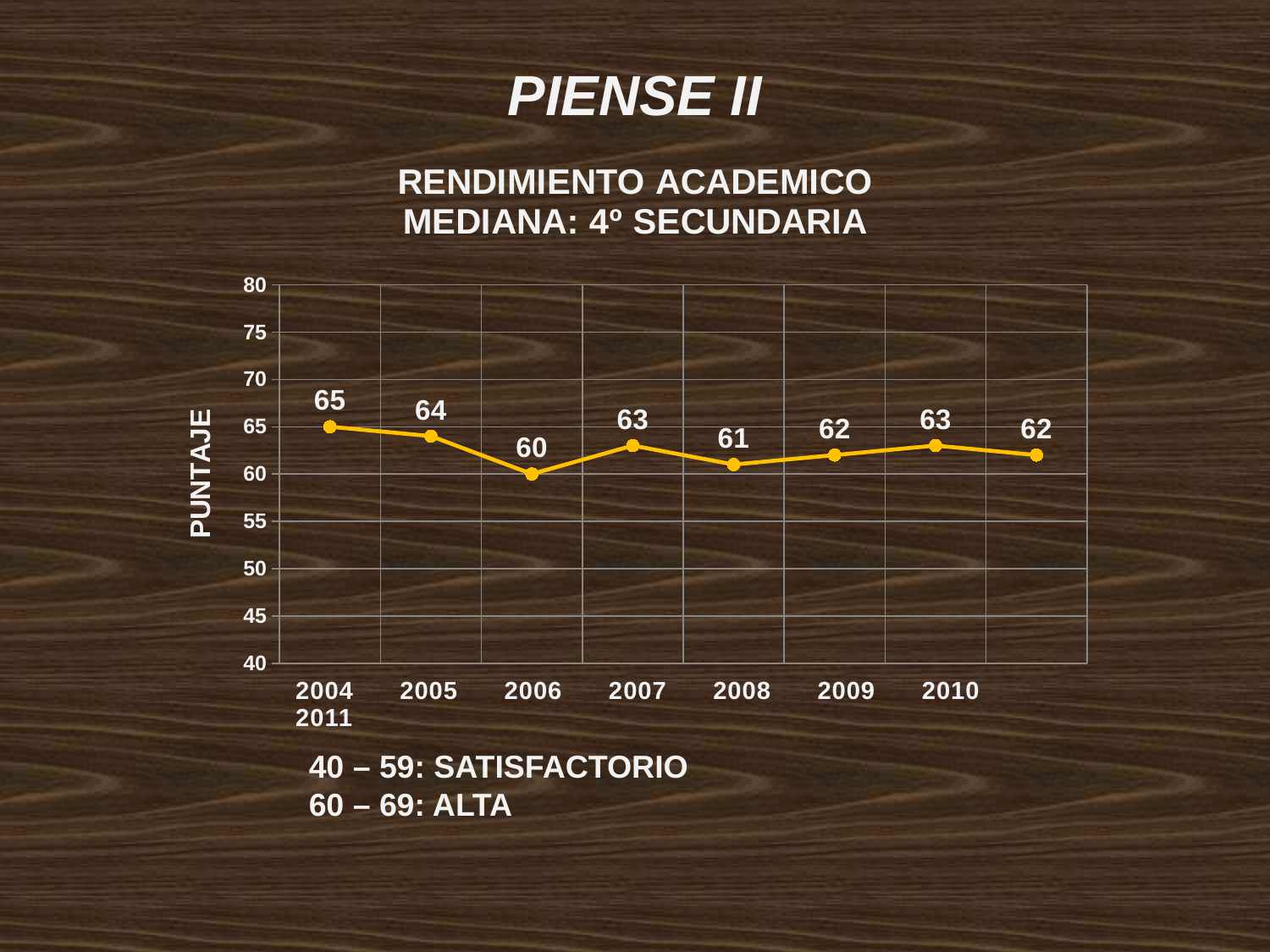
What is the label on the vertical axis of the chart? PUNTAJE How many data points are plotted on the line? 8 What is the PUNTAJE value for 2004? 65 What is the PUNTAJE value for 2008? 61 Is the PUNTAJE value for 2007 greater or less than 70? less What is the PUNTAJE value for 2010? 63 What is the difference between the PUNTAJE values for 2004 and 2006? 5 What type of chart is shown on the slide? line chart Which year has the highest PUNTAJE value? 2004 Which is larger, the PUNTAJE value for 2005 or for 2009? 2005 What is the PUNTAJE value for 2006? 60 Which year has the lowest PUNTAJE value? 2006